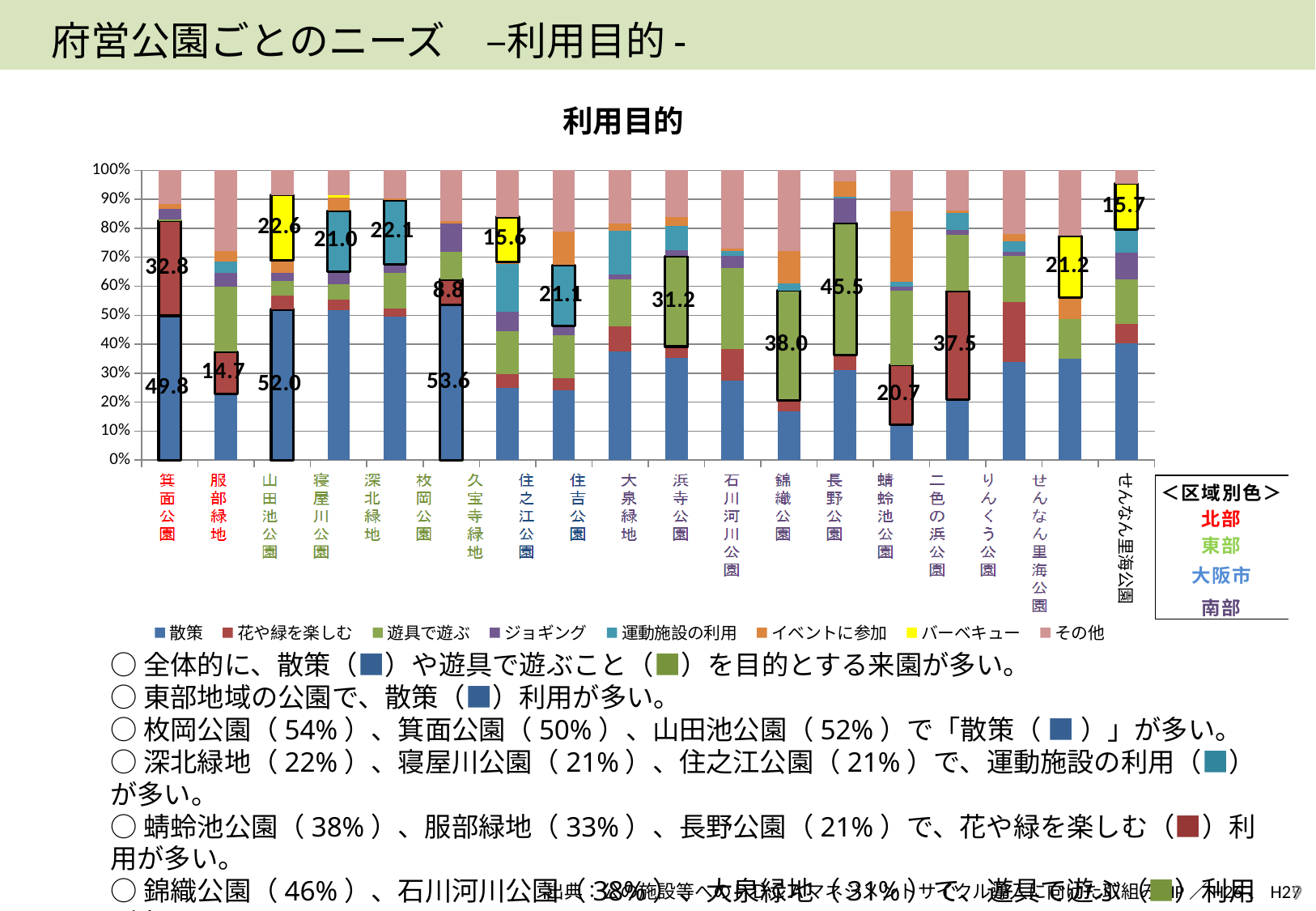
What is the difference between the labelled 散策 values of 枚岡公園 (53.6) and 箕面公園 (49.8)? 3.8 Is the 散策 share for 大泉緑地 greater or less than 50%? less What kind of chart is shown on the slide? stacked bar chart What is the title of the chart? 利用目的 What is the labelled value of 散策 for 箕面公園? 49.8 What is the labelled value of 散策 for 枚岡公園? 53.6 What is the labelled value of 遊具で遊ぶ for 錦織公園? 45.5 Which has the larger labelled 散策 value, 枚岡公園 or 箕面公園? 枚岡公園 What is the labelled value of バーベキュー for 山田池公園? 22.6 How many series does the chart legend list? 8 What is the labelled value of 運動施設の利用 for 深北緑地? 22.1